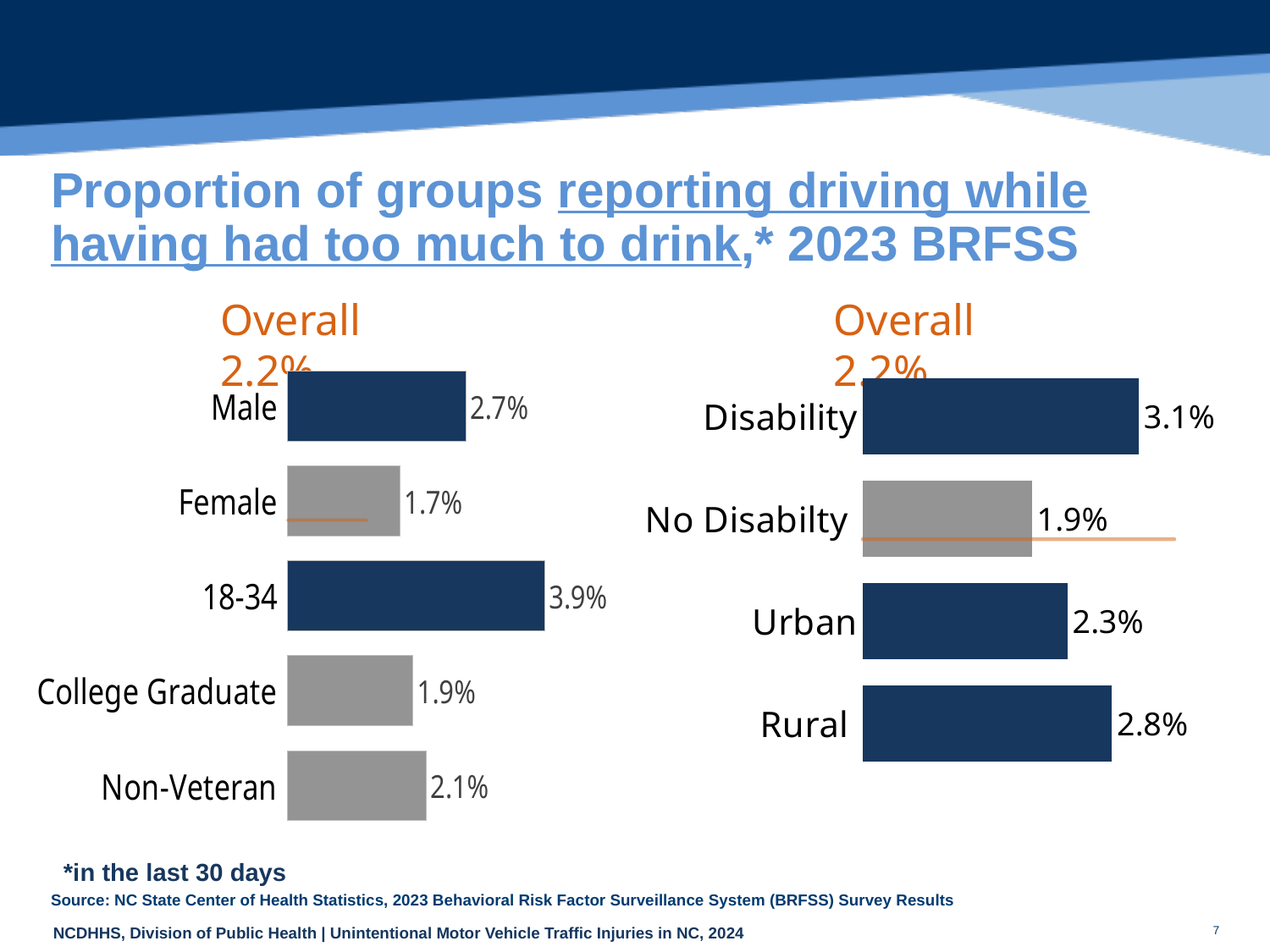
In the left chart, what is the value for 18-34? 3.9% In the left chart, what is the difference between the values for Male and Female? 1.0% In the left chart, which category has the lowest value? Female In the right chart, which category has the lowest value? No Disabilty In the left chart, what is the value for Male? 2.7% In the right chart, which is larger, the value for Urban or the value for Rural? Rural What kind of chart is the right chart? Bar chart In the left chart, which category has the highest value? 18-34 In the right chart, what is the difference between the values for Disability and No Disabilty? 1.2% In the right chart, what is the value for Rural? 2.8% In the right chart, what is the value for Disability? 3.1% How many categories are shown in the left chart? 5